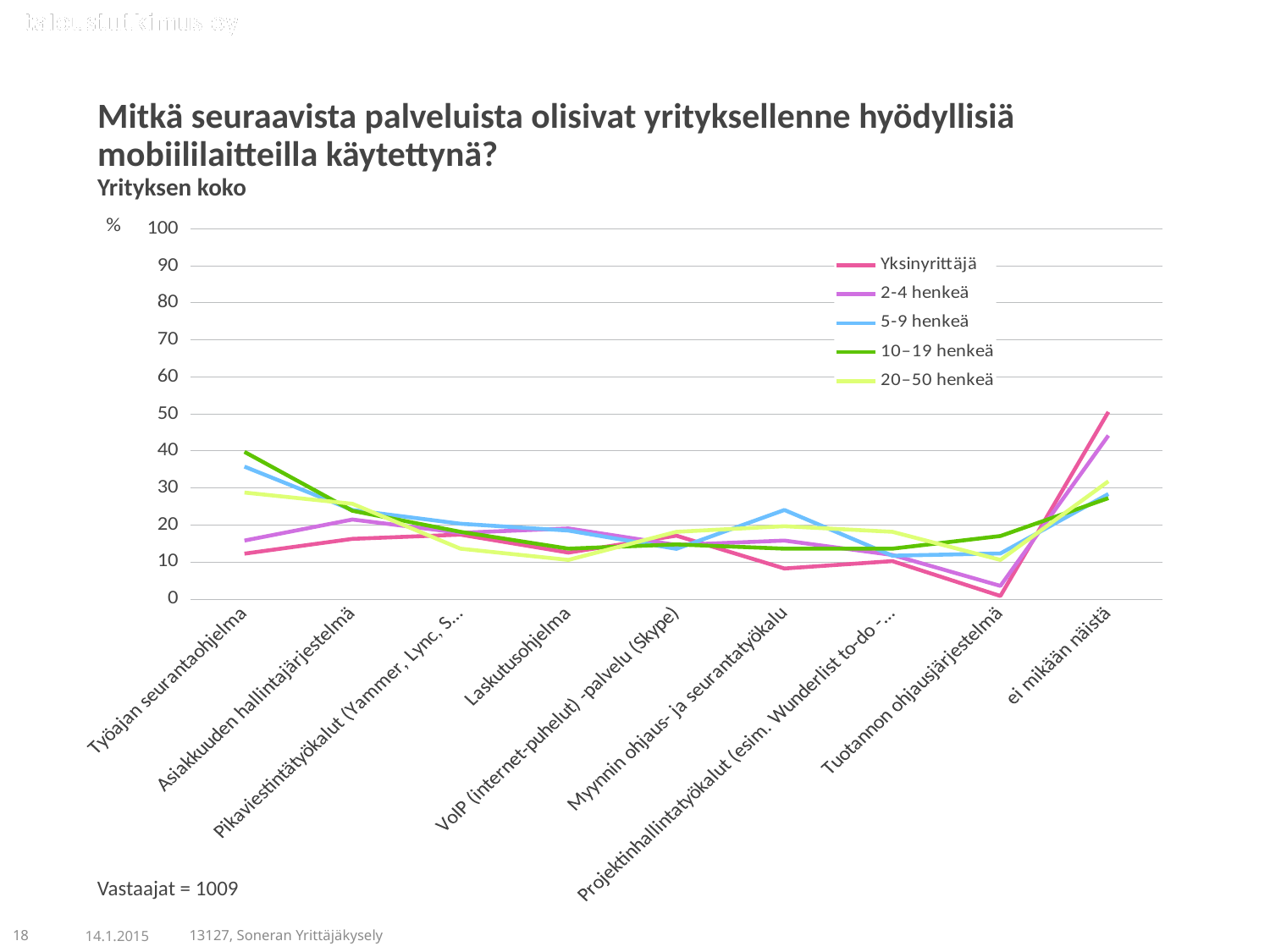
Is the value for Yksinyrittäjä at 'Tuotannon ohjausjärjestelmä' greater or less than 10? less Does the Yksinyrittäjä series rise or fall between 'Tuotannon ohjausjärjestelmä' and 'ei mikään näistä'? rise At 'Työajan seurantaohjelma', which series has the larger value: Yksinyrittäjä or 10–19 henkeä? 10–19 henkeä How many series does the legend list? 5 For which category does the Yksinyrittäjä series reach its highest value? ei mikään näistä Is the value for 5-9 henkeä at 'Myynnin ohjaus- ja seurantatyökalu' greater or less than 20? greater For which category does the Yksinyrittäjä series reach its lowest value? Tuotannon ohjausjärjestelmä Is the value for 10–19 henkeä at 'Työajan seurantaohjelma' greater or less than 30? greater How many respondents (Vastaajat) does the slide report? 1009 How many categories are plotted along the x axis? 9 What kind of chart is shown on the slide? line chart